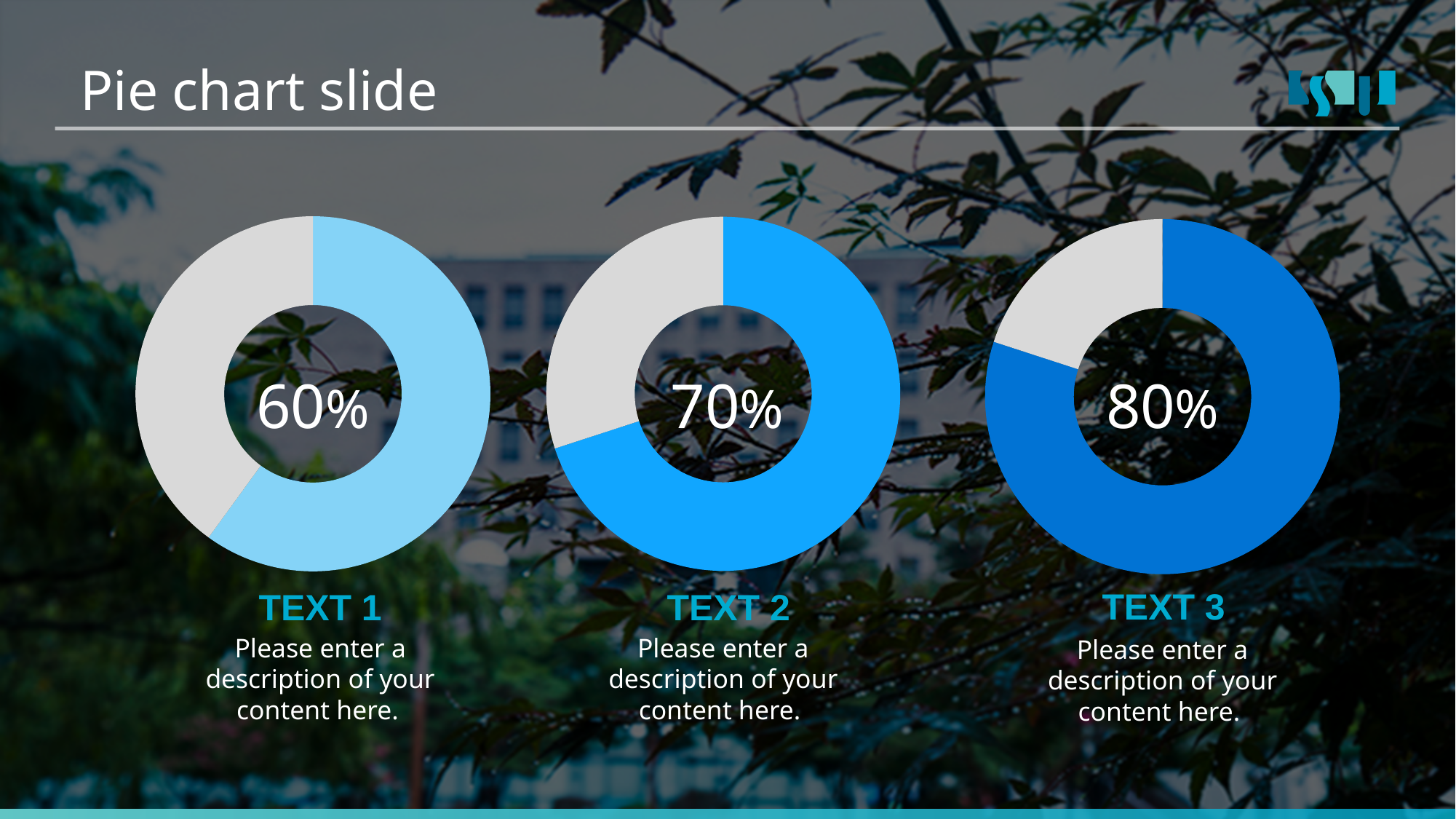
In the chart labelled TEXT 1, what percentage is shown in the centre of the donut? 60% In the chart labelled TEXT 2, what percentage is shown in the centre of the donut? 70% Which shows a larger percentage, the TEXT 2 chart or the TEXT 3 chart? TEXT 3 What kind of chart is used on this slide? Donut (pie) chart In the chart labelled TEXT 3, what percentage is shown in the centre of the donut? 80% What is the difference between the percentage shown for TEXT 3 and the percentage shown for TEXT 1? 20% Reading the three charts from left to right, do the percentages rise or fall? Rise What is the difference between the percentage shown for TEXT 2 and the percentage shown for TEXT 1? 10% Which of the three donut charts shows the lowest percentage? TEXT 1 How many donut charts are shown on the slide? 3 What is the title of the slide? Pie chart slide Which of the three donut charts shows the highest percentage? TEXT 3